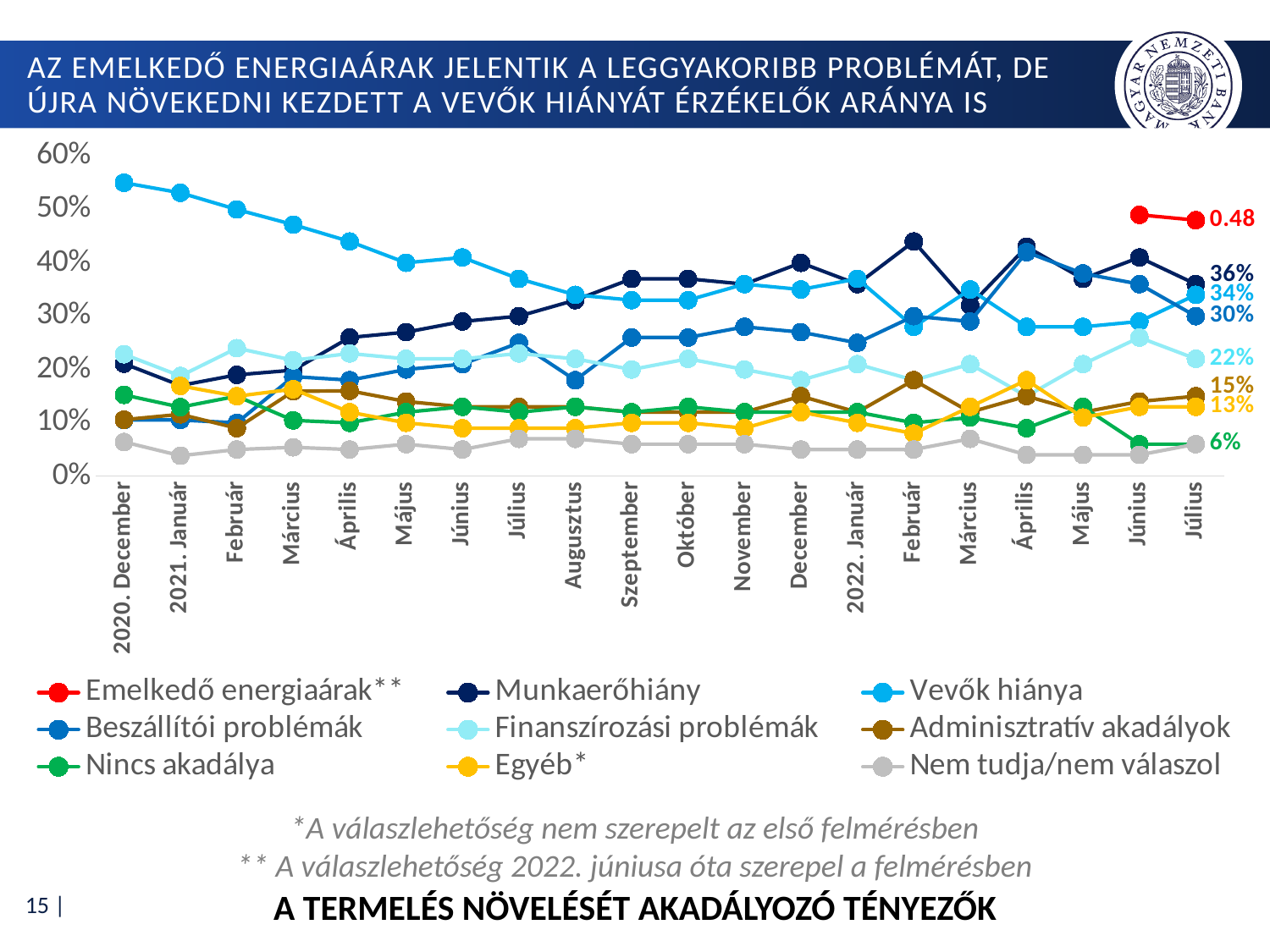
What is the value for Nincs akadálya in Július 2022? 6% Which series has the highest value in Július 2022? Emelkedő energiaárak Is the value for Vevők hiánya in 2020. December greater or less than 50%? greater What is the value for Vevők hiánya in Július 2022? 34% Does the Vevők hiánya series rise or fall from 2020. December to Augusztus 2021? fall What kind of chart is shown on the slide? line chart How many time points are shown along the x axis? 20 In Július 2022, which is larger: Beszállítói problémák or Finanszírozási problémák? Beszállítói problémák What is the value for Munkaerőhiány in Július 2022? 36% How many series does the legend list? 9 What value is labelled for Emelkedő energiaárak at the last point (Július 2022)? 0.48 In Július 2022, how much higher is Munkaerőhiány than Vevők hiánya? 2 percentage points